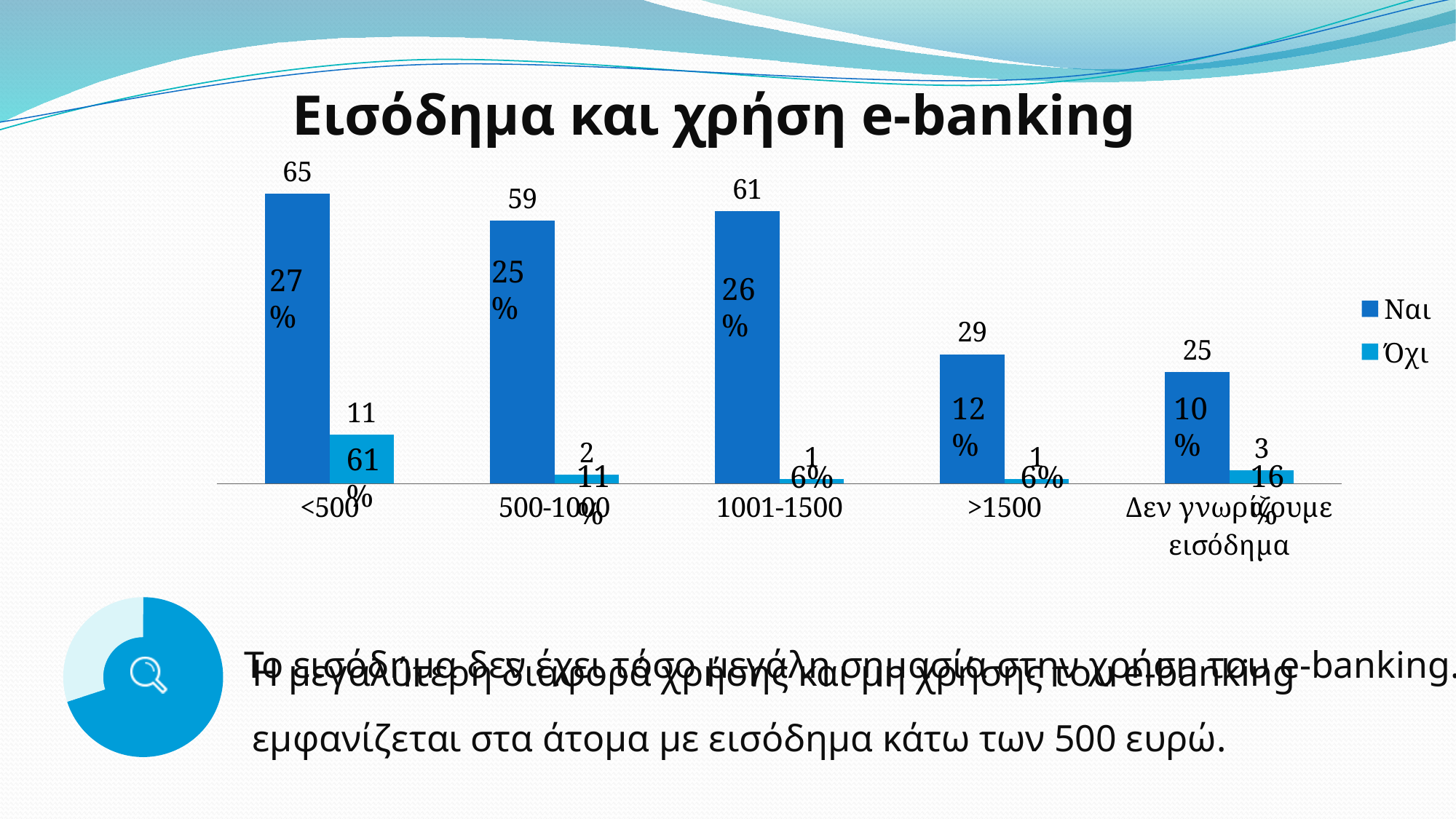
Which category has the highest Ναι value? <500 What is the title of the chart? Εισόδημα και χρήση e-banking Which category has the lowest Ναι value? Δεν γνωρίζουμε εισόδημα How many income categories are shown on the x axis? 5 Which category has the highest Όχι value? <500 Which is larger, the Ναι value for 500-1000 or the Ναι value for 1001-1500? 1001-1500 What is the value of the Ναι bar for the >1500 category? 29 What is the value of the Ναι bar for the <500 category? 65 What type of chart is shown on the slide? bar chart What is the value of the Όχι bar for the 500-1000 category? 2 How many series does the legend list? 2 What is the difference between the Ναι and Όχι values for the <500 category? 54